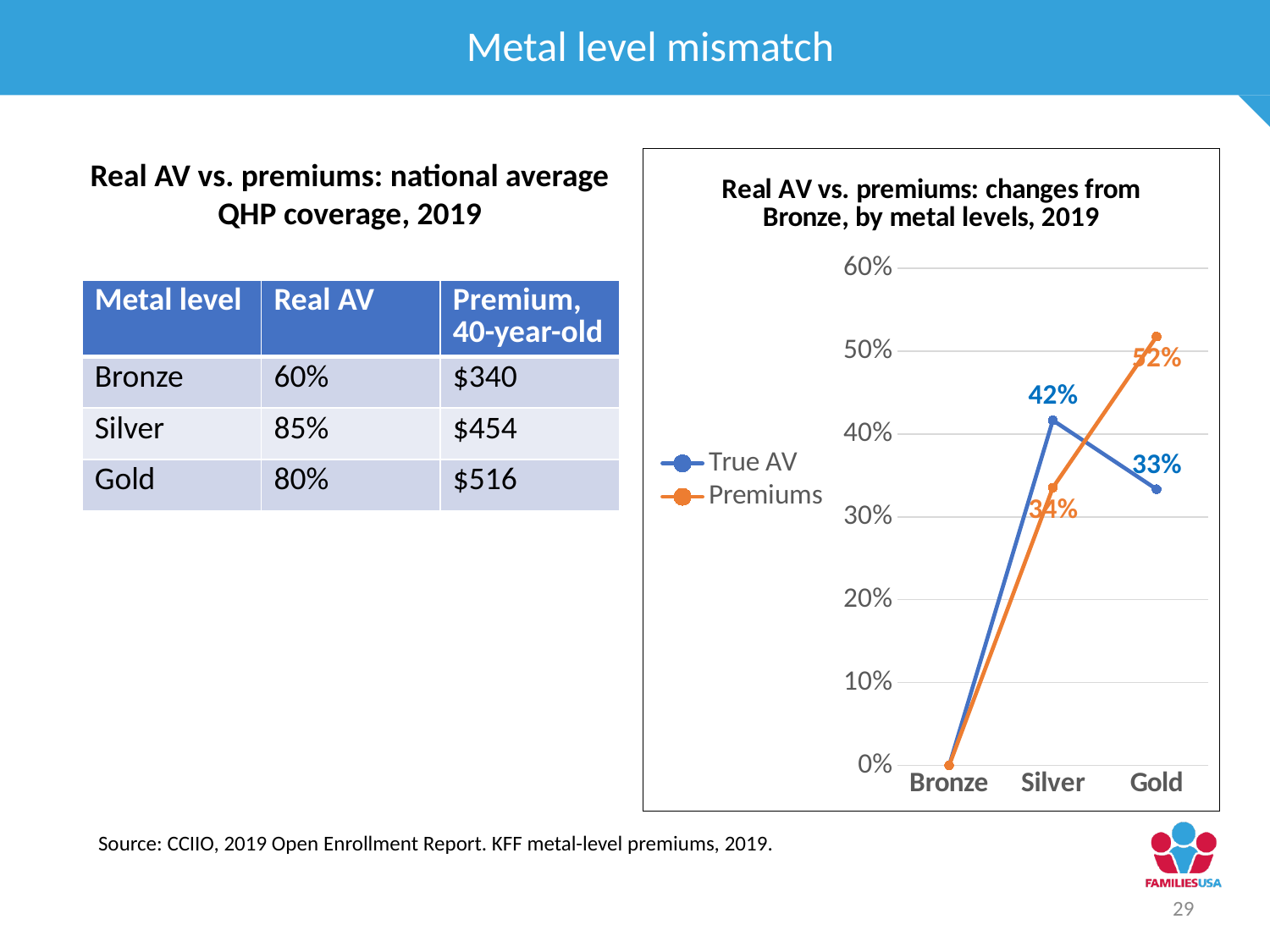
Does the True AV line rise or fall from Silver to Gold? fall What is the Premiums value for Silver in the chart? 34% What is the Premiums value for Gold in the chart? 52% By how many percentage points does the True AV value for Silver exceed the True AV value for Gold? 9 percentage points How many metal levels are plotted along the x axis of the chart? 3 At Silver, which series has the higher value, True AV or Premiums? True AV What is the value for Bronze in the chart for both series? 0% What is the True AV value for Gold in the chart? 33% At Gold, which series has the higher value, True AV or Premiums? Premiums What kind of chart is shown on the slide? line chart How many series does the chart's legend list? 2 What is the True AV value for Silver in the chart? 42%